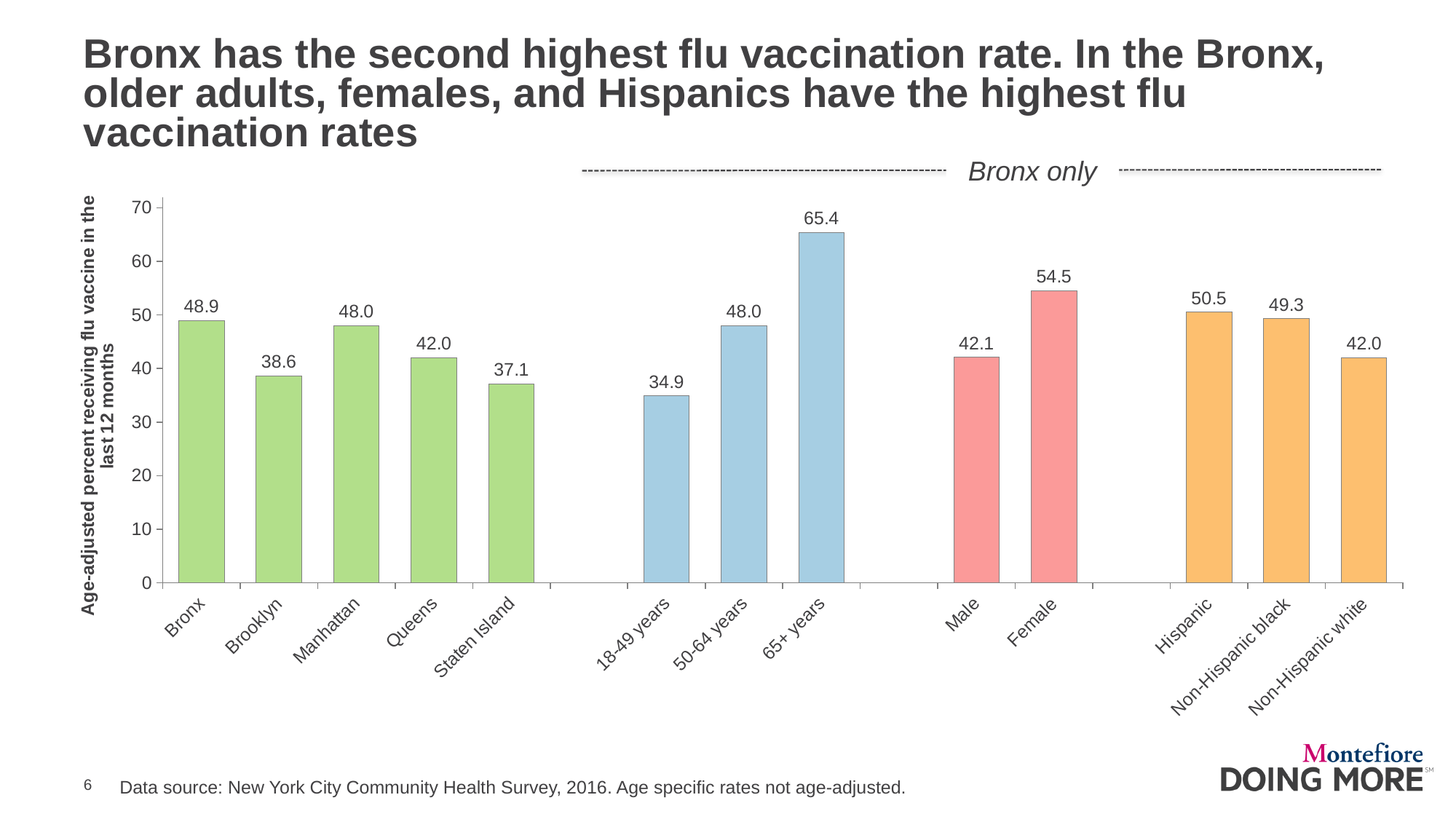
Which is larger, the rate for Hispanic or for Non-Hispanic white residents of the Bronx? Hispanic What type of chart is shown on the slide? Bar chart What is the difference between the Bronx and Staten Island flu vaccination rates? 11.8 Which category has the highest value on the whole chart? 65+ years How many bars are plotted on the chart? 13 What is the flu vaccination rate for Brooklyn? 38.6 What is the flu vaccination rate for Non-Hispanic black residents of the Bronx? 49.3 Which borough has the highest flu vaccination rate? Bronx What is the flu vaccination rate for the 65+ years group in the Bronx? 65.4 Which borough has the lowest flu vaccination rate? Staten Island Do the values rise or fall across the three age groups from 18-49 years to 65+ years? Rise What is the difference between the Female and Male flu vaccination rates in the Bronx? 12.4